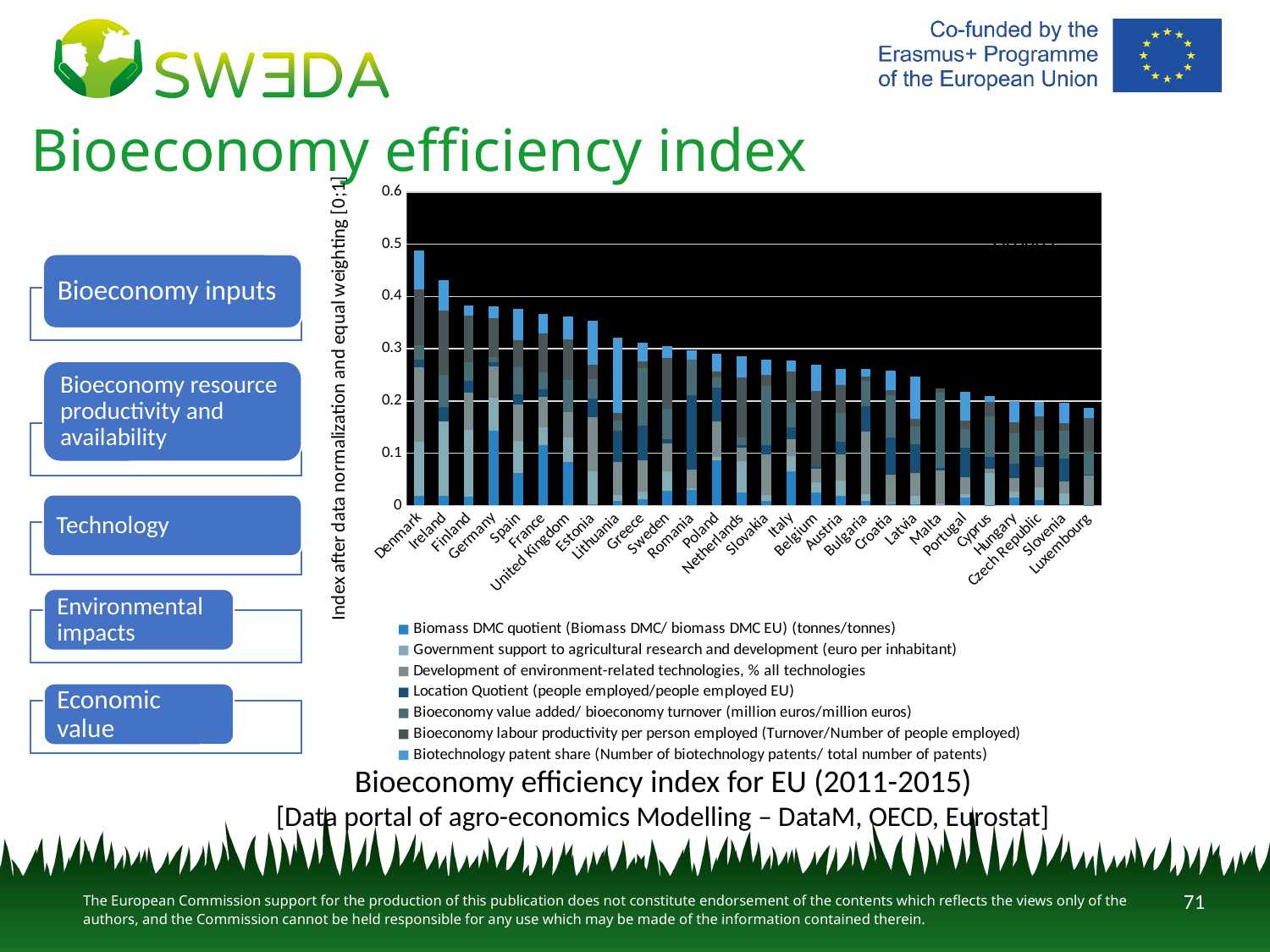
Which country has the highest total bar in the chart? Denmark How many countries are shown along the x axis of the chart? 28 Is the total value for Denmark greater or less than 0.4? greater Which country has a larger total bar, Ireland or Malta? Ireland Which country has the lowest total bar in the chart? Luxembourg How many series does the legend of the chart list? 7 Is the total value for Finland greater or less than 0.3? greater What is the label of the vertical axis of the chart? Index after data normalization and equal weighting [0;1] What kind of chart is shown on the slide? Stacked bar chart Is the total value for Luxembourg greater or less than 0.3? less Do the total bar values rise or fall moving from left to right along the x axis? Fall